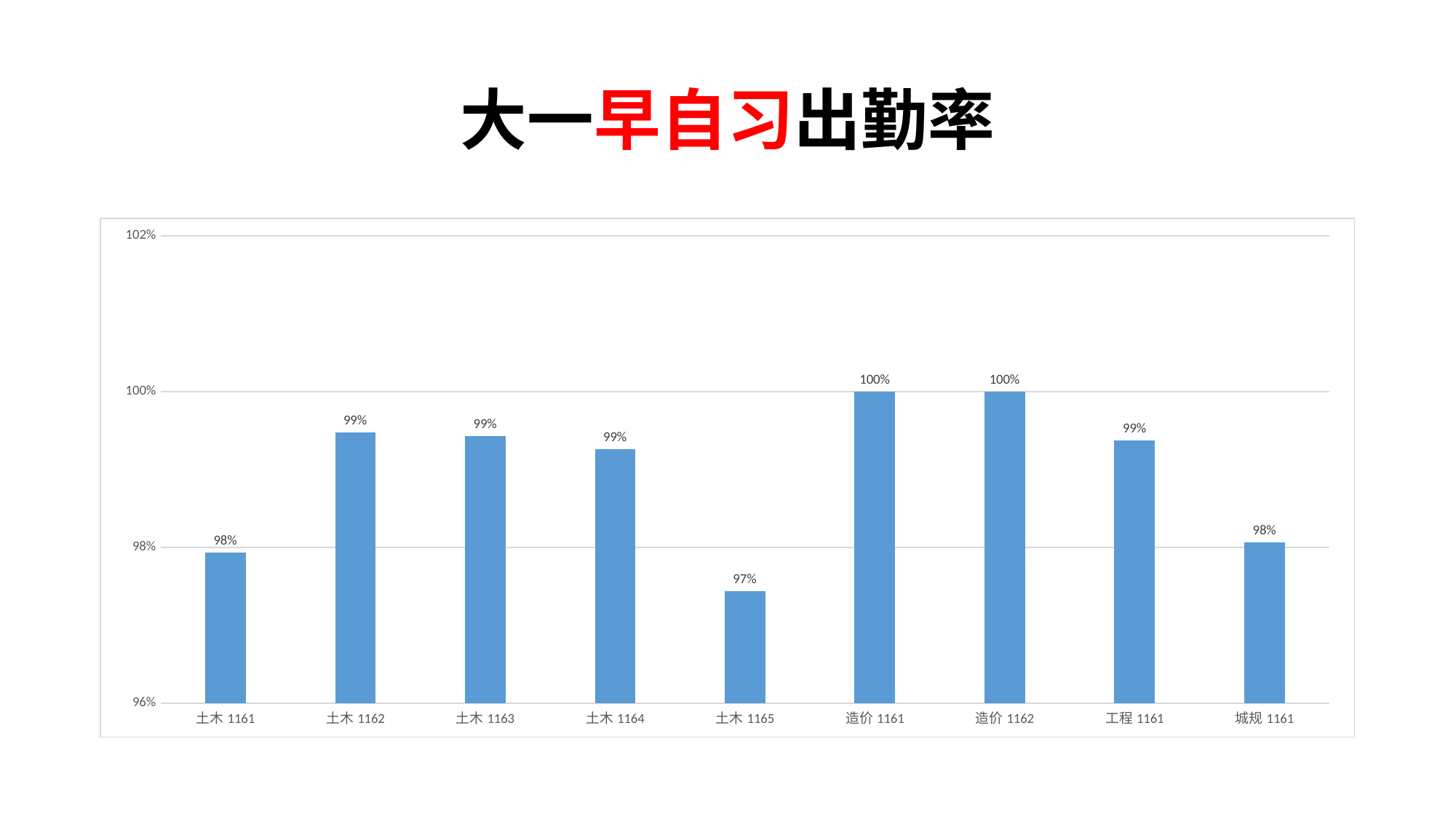
How many classes are shown on the x axis? 9 Is the value for 土木 1165 greater or less than 98%? less What is the difference between the attendance rates of 造价 1162 and 土木 1165? 3% What is the attendance rate shown for 工程 1161? 99% What kind of chart is shown on the slide? bar chart Which has a higher attendance rate, 造价 1161 or 土木 1165? 造价 1161 What is the attendance rate shown for 造价 1161? 100% What is the title of the slide? 大一早自习出勤率 What is the attendance rate shown for 土木 1165? 97% Is the value for 土木 1162 greater or less than 98%? greater Which class has the lowest attendance rate? 土木 1165 What is the attendance rate shown for 城规 1161? 98%